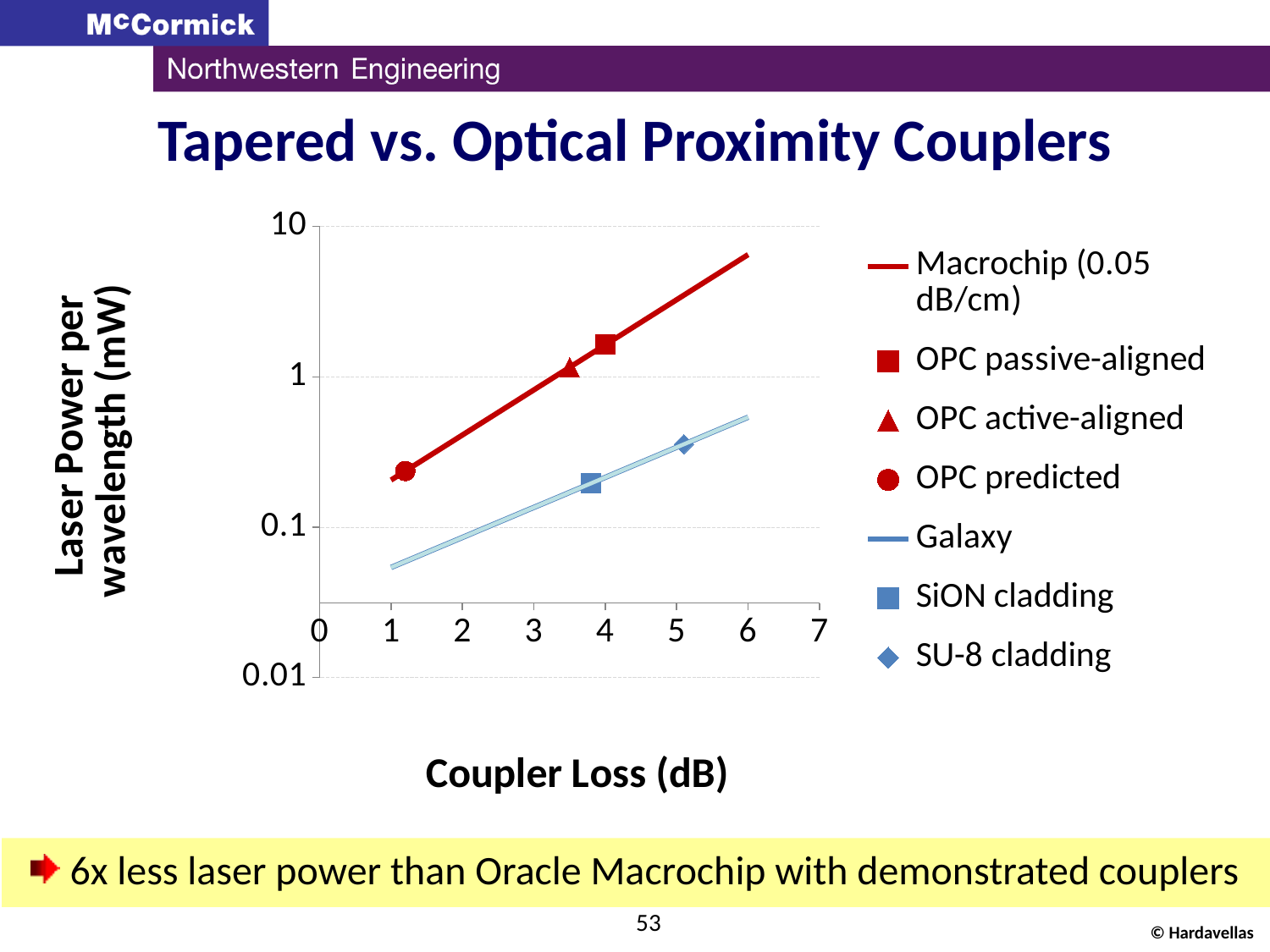
What is the title of the y axis? Laser Power per wavelength (mW) Which of the plotted points has the lowest laser power? SiON cladding Which line lies higher on the chart, Macrochip (0.05 dB/cm) or Galaxy? Macrochip (0.05 dB/cm) Is the laser power value for OPC passive-aligned greater or less than 1? greater Which point has the higher laser power, OPC passive-aligned or SiON cladding? OPC passive-aligned What kind of chart is shown on the slide? line chart Is the laser power value for OPC predicted greater or less than 1? less Is the laser power value for SiON cladding greater or less than 1? less What is the title of the x axis? Coupler Loss (dB) Does the Macrochip (0.05 dB/cm) line rise or fall as coupler loss increases? rise How many series does the legend list? 7